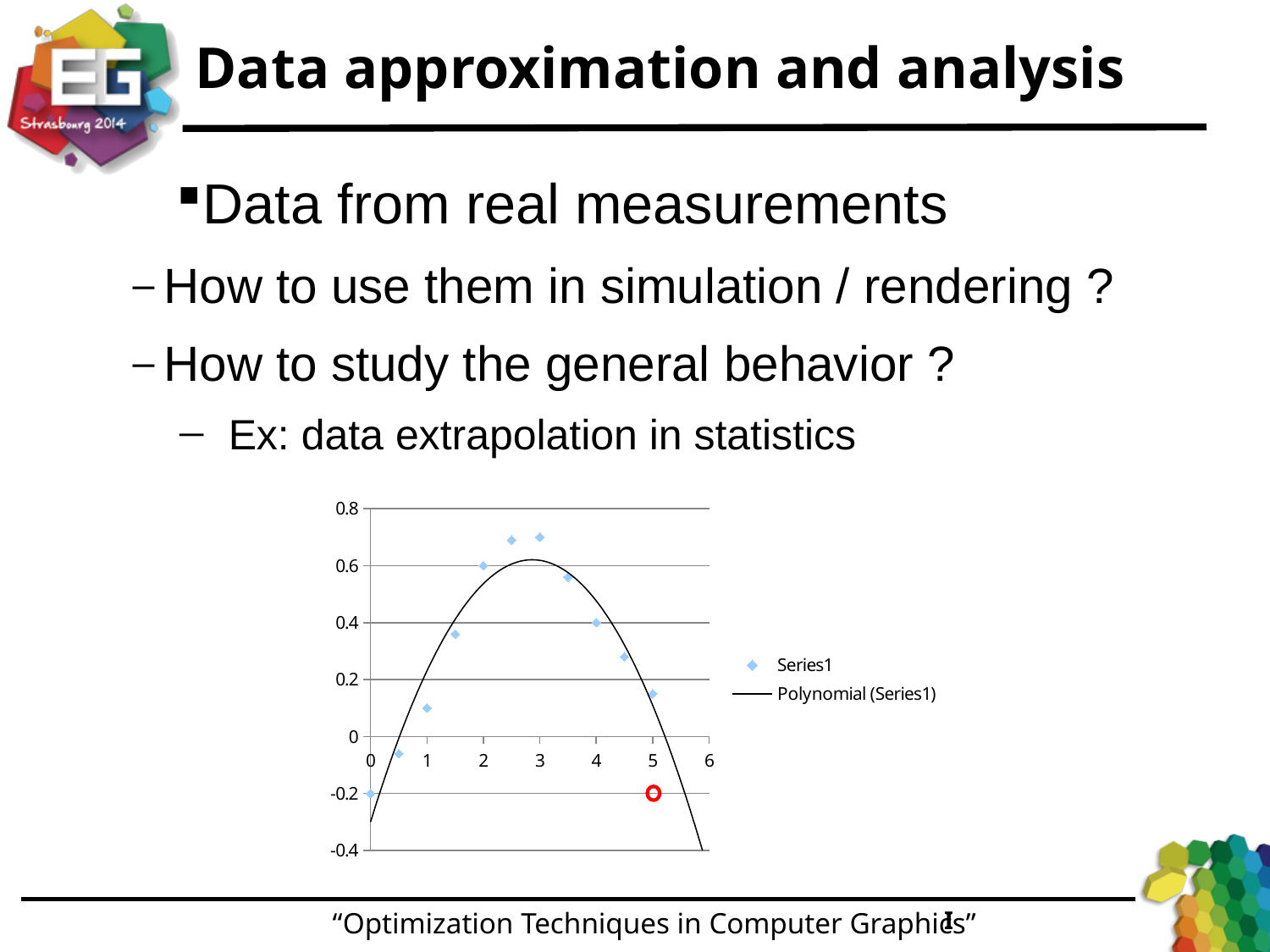
Is the Series1 value at x = 0 greater or less than 0? less How many series does the chart legend list? 2 Is the Series1 value at x = 4.5 greater or less than 0.4? less At which x value does Series1 have its lowest point? 0 Is the Series1 value at x = 3 greater or less than 0.6? greater How do the Series1 values change as x increases from 0 to 5? They rise to a peak around x = 3 and then fall How many data points are plotted for Series1? 11 What are the two entries in the chart legend? Series1 and Polynomial (Series1) Which is larger, the Series1 value at x = 2 or at x = 4? x = 2 What kind of chart is shown on the slide? scatter chart